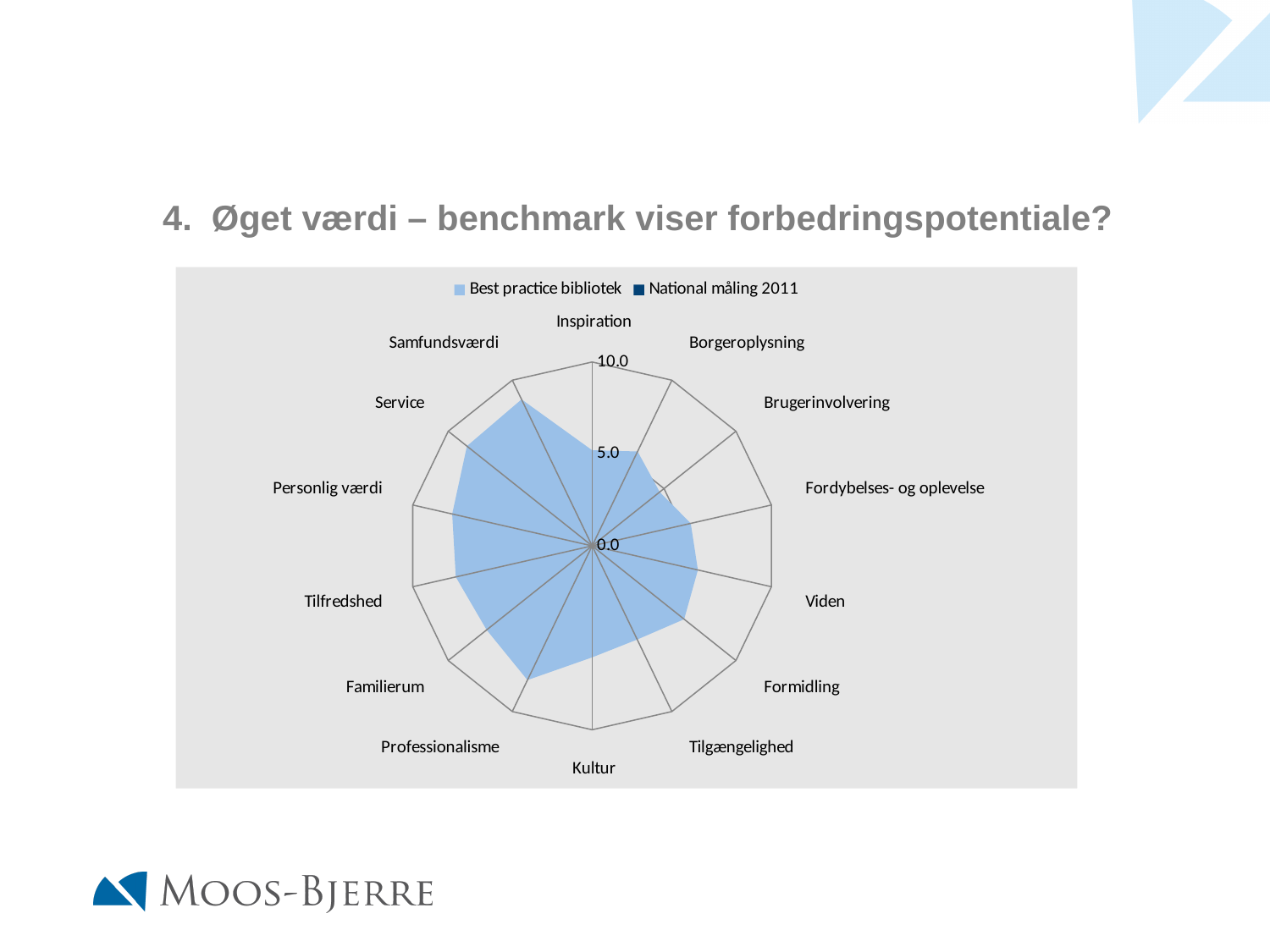
For Best practice bibliotek, which is larger: the value for Professionalisme or the value for Kultur? Professionalisme For Best practice bibliotek, which is larger: the value for Service or the value for Viden? Service How many series does the legend of the chart list? 2 Is the value for Professionalisme for Best practice bibliotek greater or less than 5.0? greater How many categories (axes) does the radar chart have? 14 What is the highest value shown on the chart's radial axis? 10.0 Is the value for Samfundsværdi for Best practice bibliotek greater or less than 5.0? greater Is the value for Service for Best practice bibliotek greater or less than 10.0? less What kind of chart is shown on the slide? Radar chart What are the two series named in the chart legend? Best practice bibliotek and National måling 2011 For Best practice bibliotek, which is larger: the value for Samfundsværdi or the value for Brugerinvolvering? Samfundsværdi